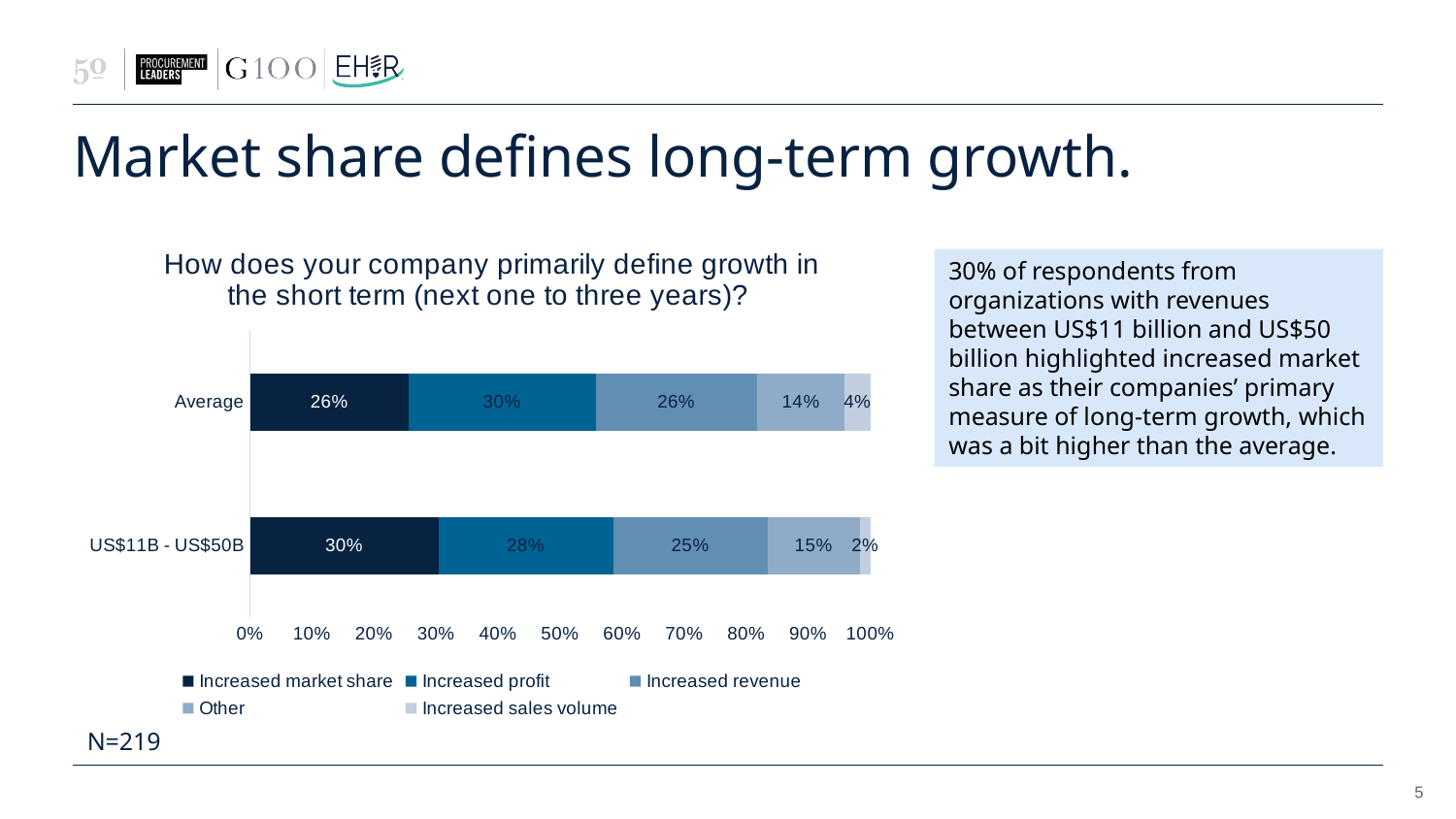
What is the value for Increased market share in the US$11B - US$50B bar? 30% What is the value for Increased profit in the Average bar? 30% What is the value for Other in the Average bar? 14% How many categories (bars) are plotted in the chart? 2 What is the value for Increased sales volume in the US$11B - US$50B bar? 2% What kind of chart is shown on the slide? Stacked bar chart What is the difference between the Increased market share values for US$11B - US$50B and Average? 4% Which segment is the smallest in the US$11B - US$50B bar? Increased sales volume Which is larger: Increased profit for Average or Increased profit for US$11B - US$50B? Average How many series does the legend list? 5 Which segment is the largest in the Average bar? Increased profit What is the value for Increased revenue in the US$11B - US$50B bar? 25%